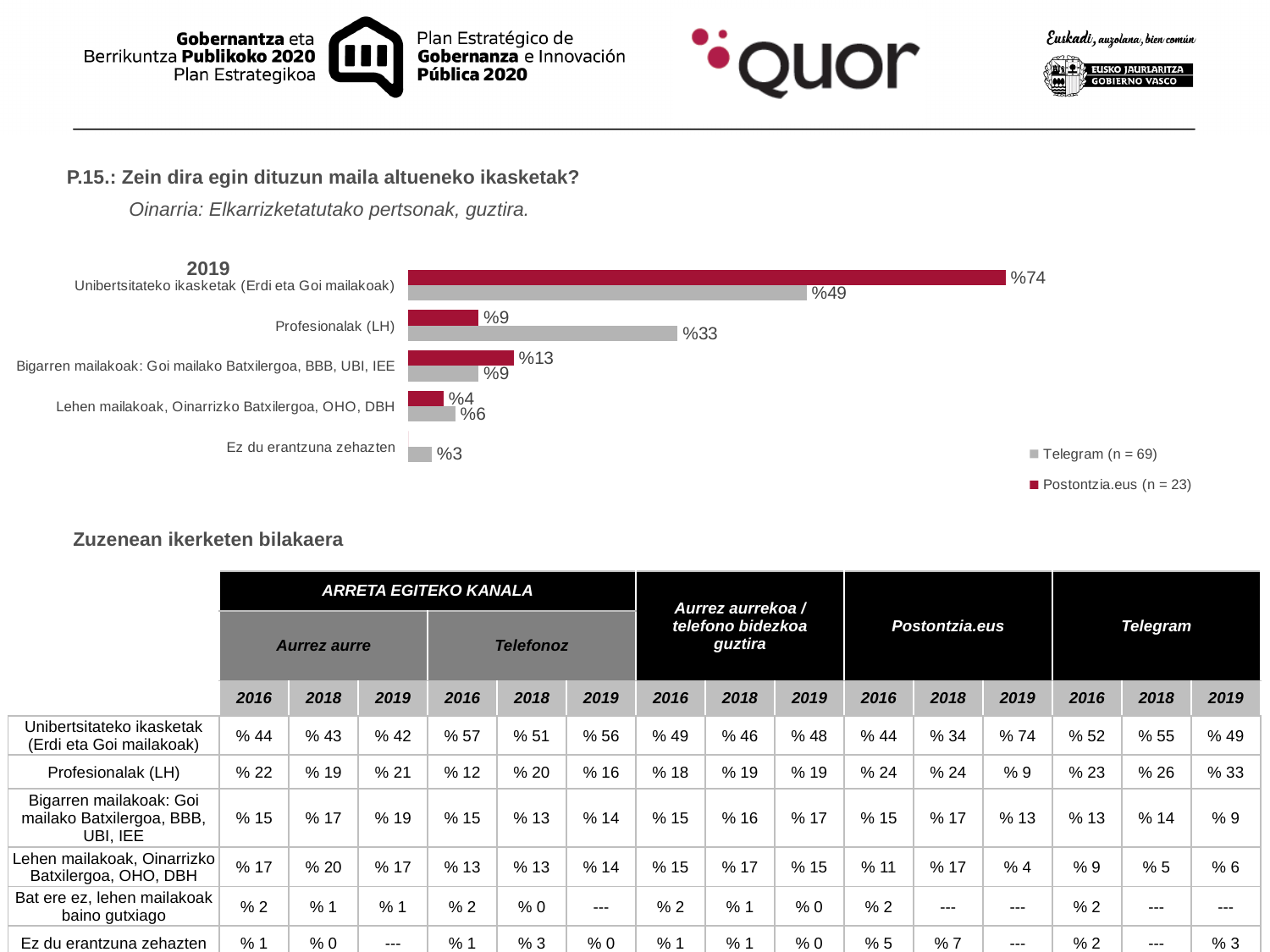
How many series does the chart legend list? 2 For Profesionalak (LH), which series has the larger value, Telegram or Postontzia.eus? Telegram What sample size (n) does the legend give for Postontzia.eus? 23 What is the difference between the Postontzia.eus and Telegram values for Unibertsitateko ikasketak (Erdi eta Goi mailakoak)? 25 What is the Postontzia.eus value for Bigarren mailakoak: Goi mailako Batxilergoa, BBB, UBI, IEE? %13 Which category has the highest Telegram value? Unibertsitateko ikasketak (Erdi eta Goi mailakoak) What is the Telegram value for Profesionalak (LH)? %33 What is the Postontzia.eus value for Unibertsitateko ikasketak (Erdi eta Goi mailakoak)? %74 What is the Telegram value for Ez du erantzuna zehazten? %3 Which category has the lowest Postontzia.eus value among those with a labelled bar? Lehen mailakoak, Oinarrizko Batxilergoa, OHO, DBH What is the difference between the Telegram and Postontzia.eus values for Profesionalak (LH)? 24 What kind of chart is shown on the slide? bar chart